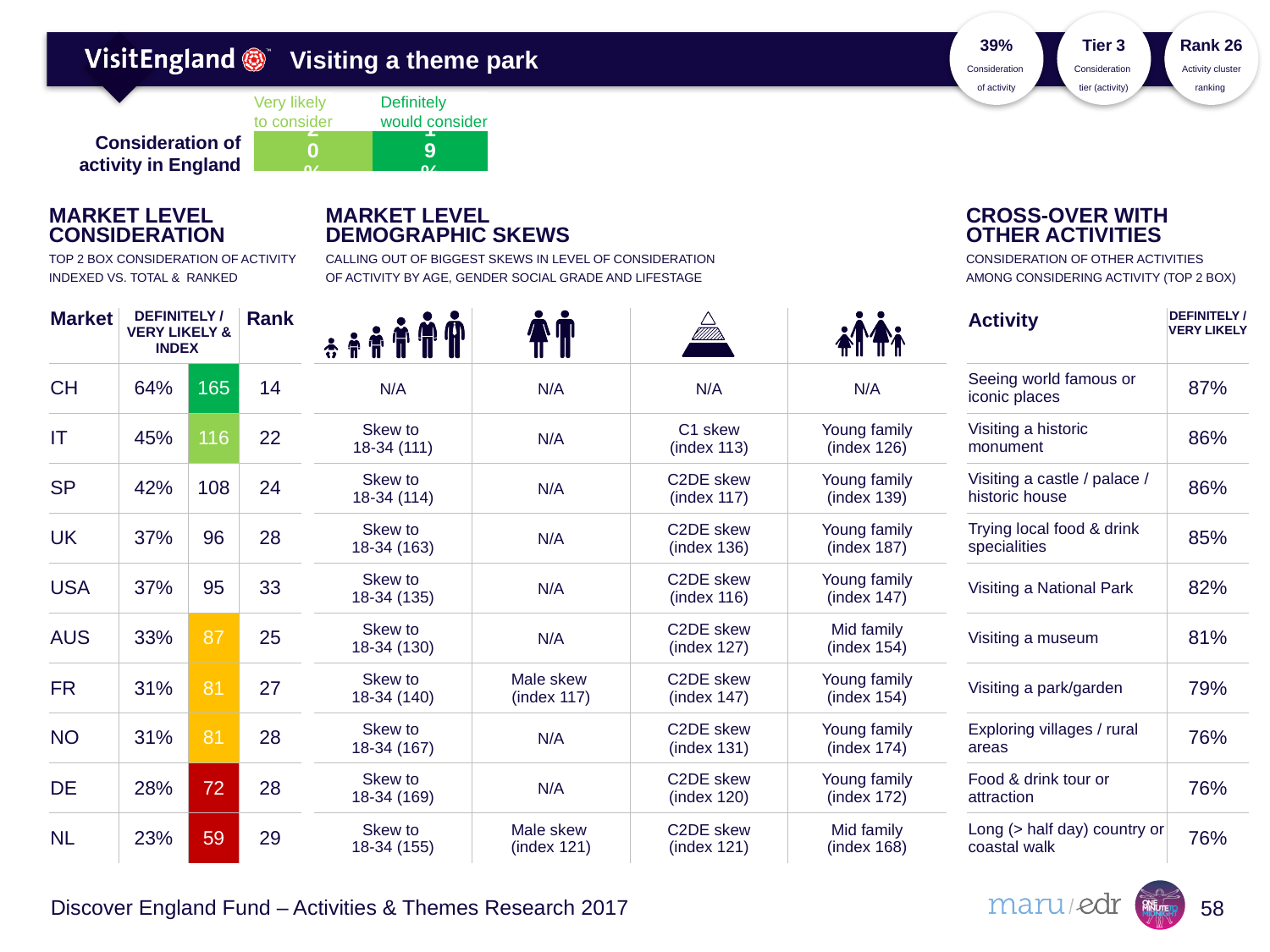
What is the total of the two segments in the "Consideration of activity in England" bar chart? 39% What kind of chart is shown next to "Consideration of activity in England"? bar chart In the "Consideration of activity in England" bar chart, which segment is shown in the darker green? Definitely would consider In the "Consideration of activity in England" bar chart, what is the difference between "Very likely to consider" and "Definitely would consider"? 1% In the "Consideration of activity in England" bar chart, what is the value for "Very likely to consider"? 20% What are the two segment labels in the "Consideration of activity in England" bar chart? Very likely to consider; Definitely would consider In the "Consideration of activity in England" bar chart, which segment is larger: "Very likely to consider" or "Definitely would consider"? Very likely to consider How many segments (series) does the "Consideration of activity in England" bar chart show? 2 In the "Consideration of activity in England" bar chart, what is the value for "Definitely would consider"? 19%